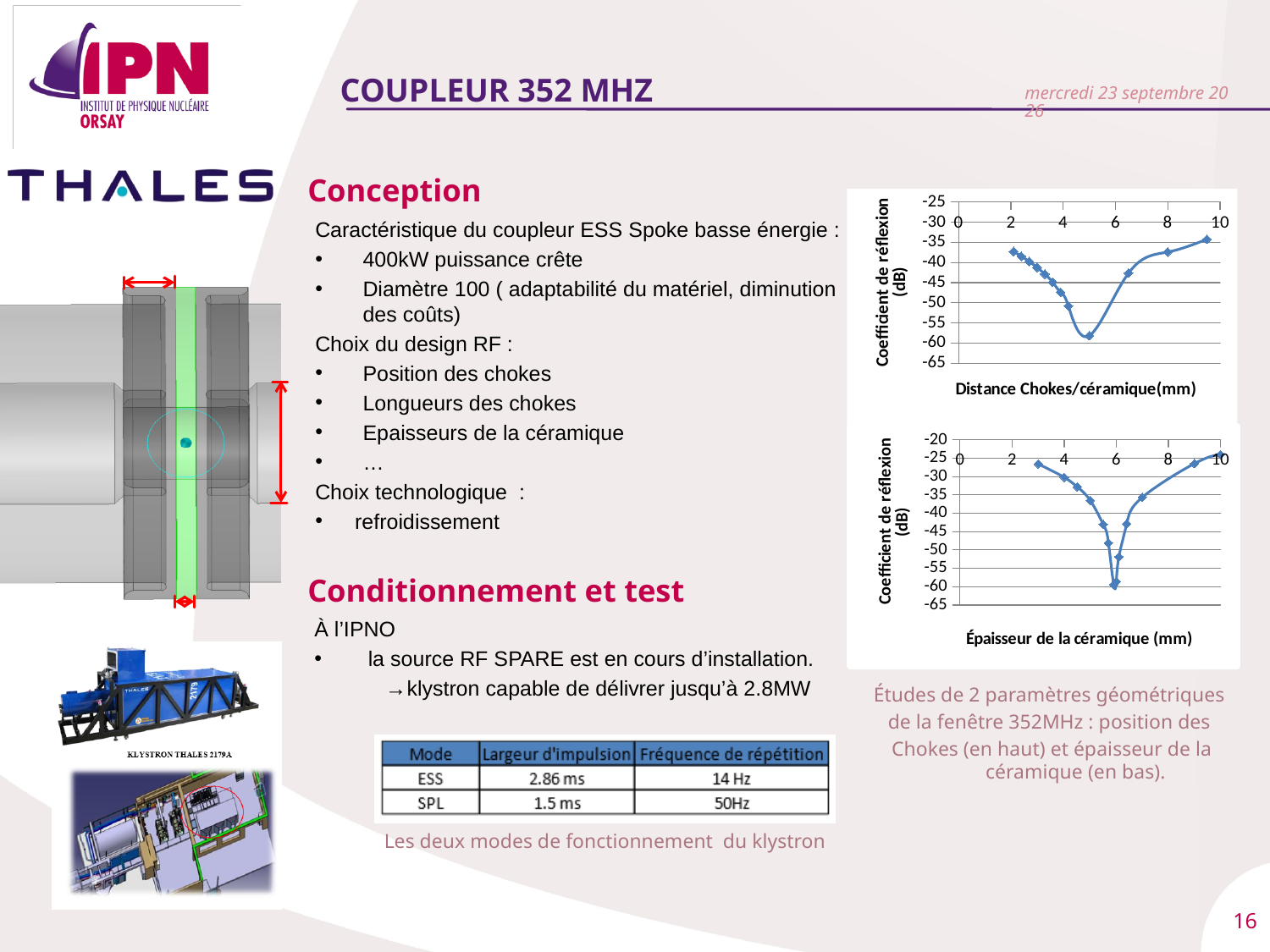
In the bottom chart, is the value at a thickness of 10 mm greater or less than -30? greater In the top chart, is the value at a distance of 5 mm greater or less than -50? less In the bottom chart, what is the x-axis title? Épaisseur de la céramique (mm) In the bottom chart, do the values rise or fall as the thickness increases from 6 mm to 10 mm? rise What kind of chart is the top chart on the slide (Distance Chokes/céramique)? line chart In the top chart, do the values rise or fall as the distance increases from 2 mm to 5 mm? fall In the bottom chart, is the value at a thickness of 6 mm greater or less than -50? less In the top chart, what is the x-axis title? Distance Chokes/céramique(mm) What kind of chart is the bottom chart on the slide (Épaisseur de la céramique)? line chart